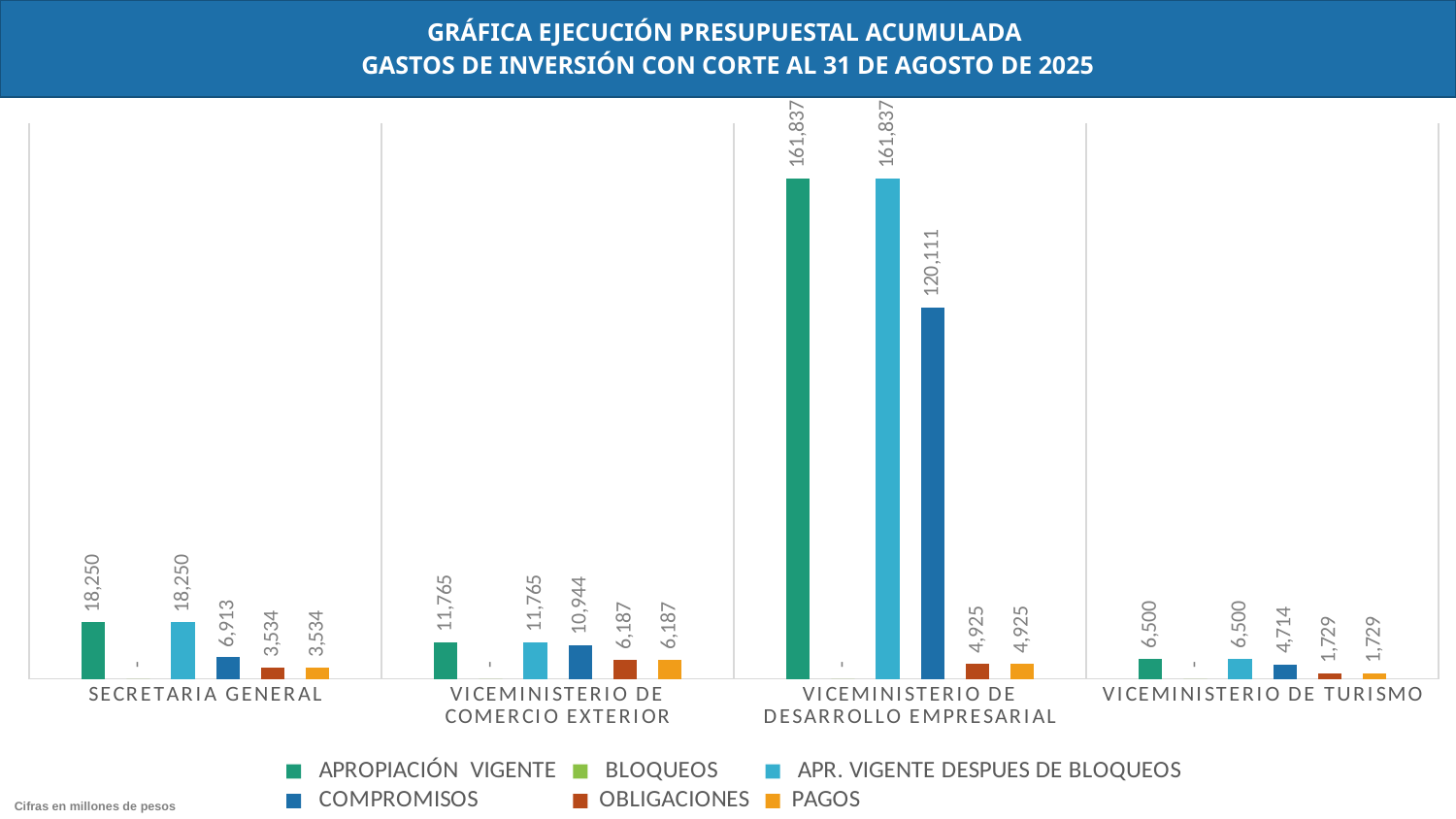
What is the APROPIACIÓN VIGENTE value for VICEMINISTERIO DE DESARROLLO EMPRESARIAL? 161,837 What is the difference between APR. VIGENTE DESPUES DE BLOQUEOS and COMPROMISOS for VICEMINISTERIO DE DESARROLLO EMPRESARIAL? 41,726 What is the difference between COMPROMISOS and OBLIGACIONES for SECRETARIA GENERAL? 3,379 What is the COMPROMISOS value for SECRETARIA GENERAL? 6,913 What is the OBLIGACIONES value for VICEMINISTERIO DE COMERCIO EXTERIOR? 6,187 How many series does the legend list? 6 Which is larger: the APROPIACIÓN VIGENTE for SECRETARIA GENERAL or for VICEMINISTERIO DE COMERCIO EXTERIOR? SECRETARIA GENERAL Which category has the highest APROPIACIÓN VIGENTE? VICEMINISTERIO DE DESARROLLO EMPRESARIAL What is the PAGOS value for VICEMINISTERIO DE TURISMO? 1,729 Which category has the lowest COMPROMISOS value? VICEMINISTERIO DE TURISMO How many categories are shown on the x axis? 4 What kind of chart is shown on the slide? Bar chart